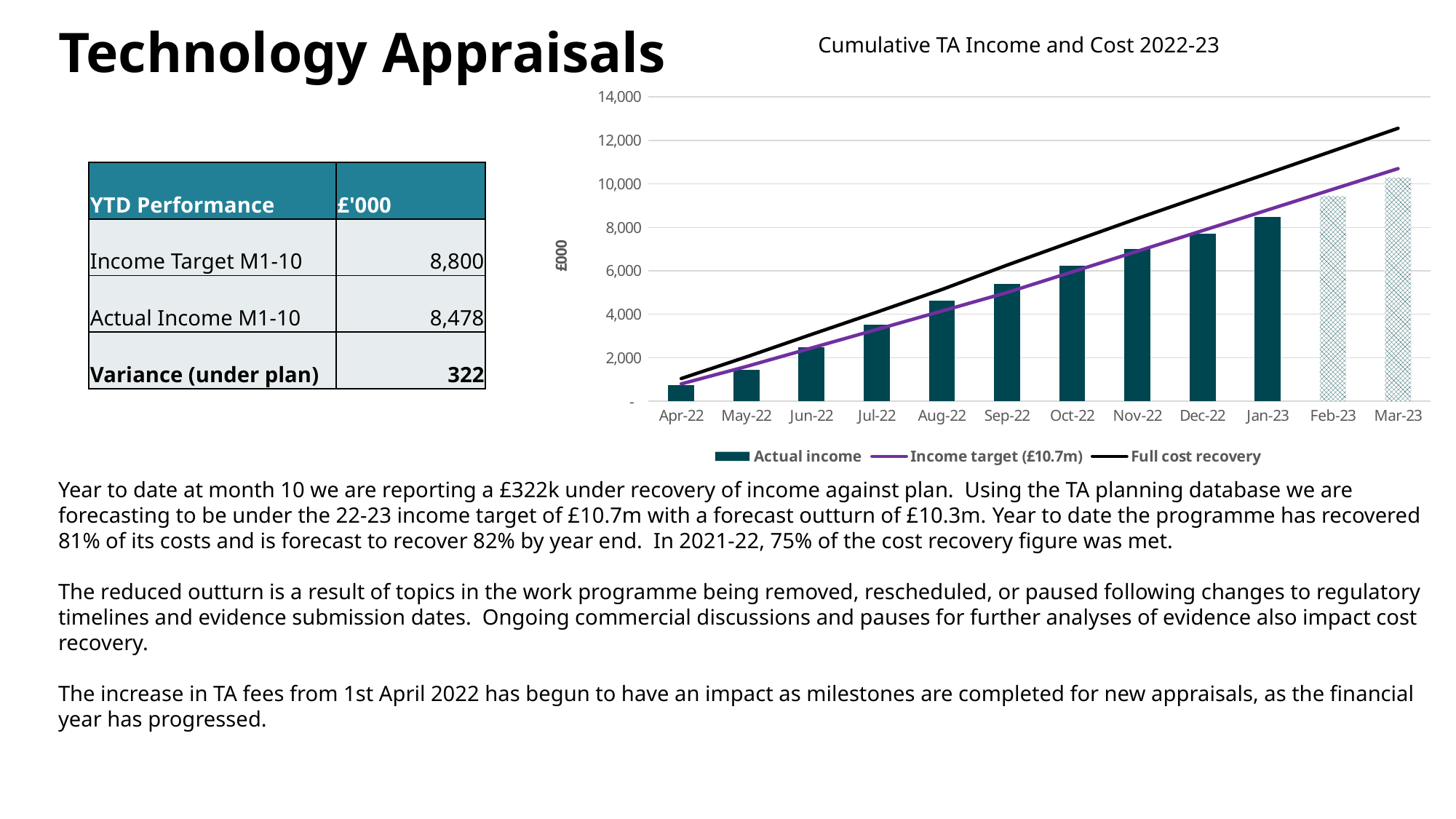
Is the Actual income value for Jan-23 greater or less than 8,000? greater What is the title of the chart on the slide? Cumulative TA Income and Cost 2022-23 At Mar-23, which line is higher: Full cost recovery or Income target (£10.7m)? Full cost recovery Is the Actual income value for Nov-22 greater or less than 6,000? greater Is the Actual income value for Apr-22 greater or less than 2,000? less Which month has the highest bar in the chart? Mar-23 Do the Actual income bars rise or fall from Apr-22 to Mar-23? rise How many series does the chart legend list? 3 Which series in the chart is drawn as bars? Actual income How many months are shown along the x axis of the chart? 12 Which month has the lowest Actual income bar? Apr-22